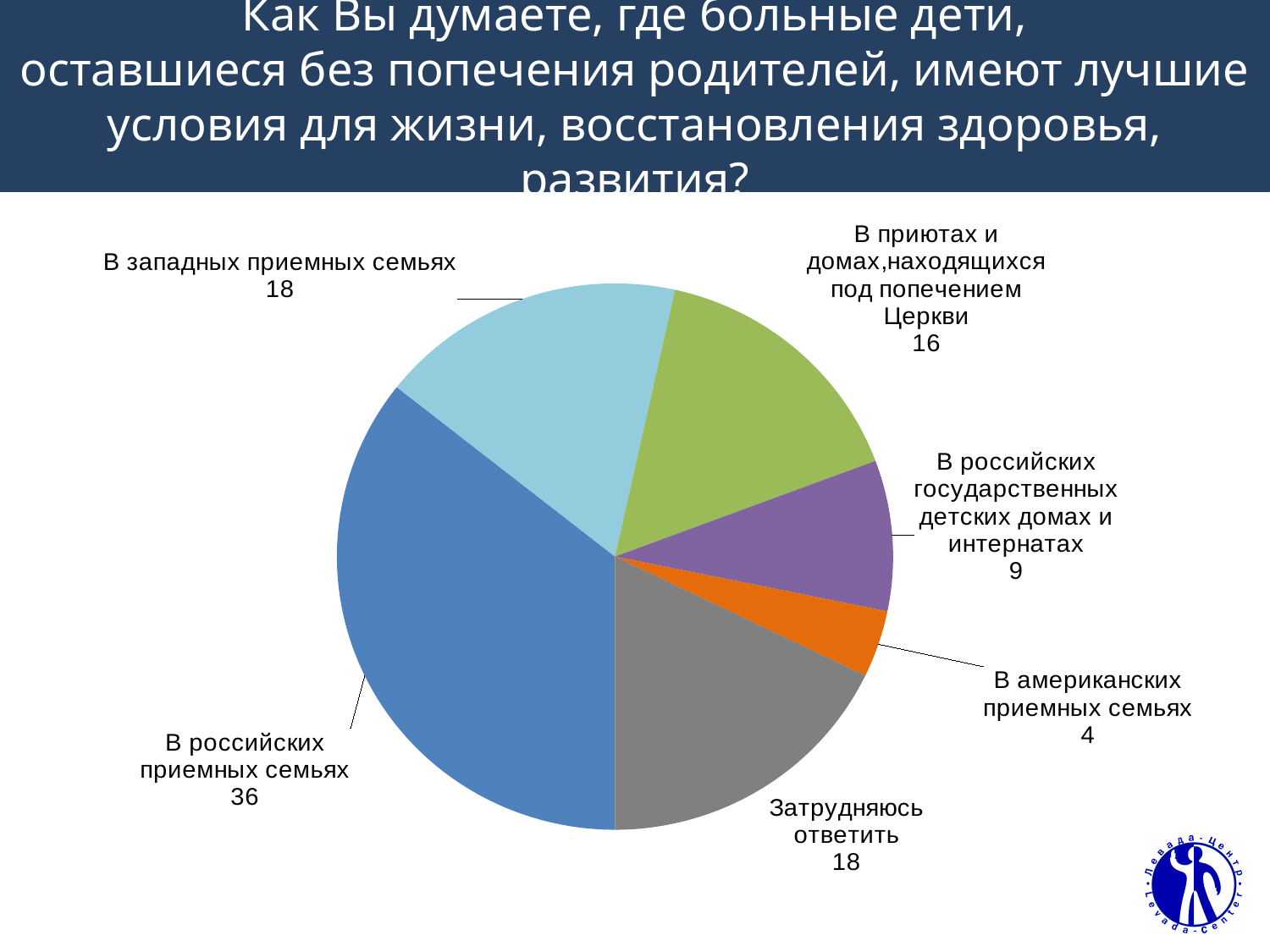
What kind of chart is shown on the slide? Pie chart What is the value for "В российских государственных детских домах и интернатах"? 9 What is the value for "В российских приемных семьях"? 36 What is the difference between the values for "В российских приемных семьях" and "В западных приемных семьях"? 18 How many slices does the pie chart have? 6 What is the value for "В американских приемных семьях"? 4 What is the value for "Затрудняюсь ответить"? 18 What colour is the slice for "В американских приемных семьях"? Orange Which category has the largest slice of the pie? В российских приемных семьях Which category has the smallest slice of the pie? В американских приемных семьях What is the value for "В приютах и домах, находящихся под попечением Церкви"? 16 Which is larger: the value for "В приютах и домах, находящихся под попечением Церкви" or the value for "В российских государственных детских домах и интернатах"? В приютах и домах, находящихся под попечением Церкви